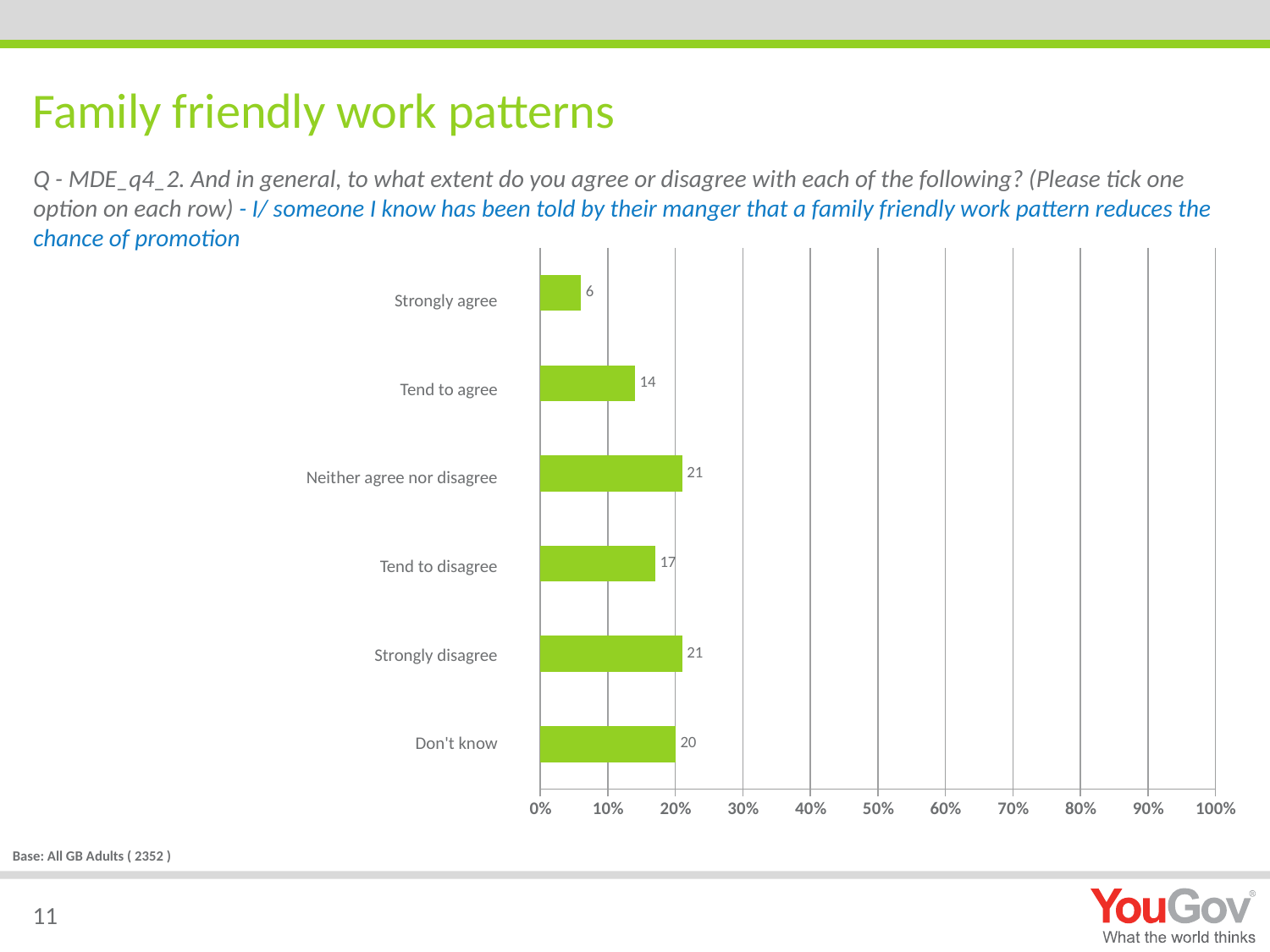
What is the difference between the values for "Neither agree nor disagree" and "Tend to agree"? 7 What is the value for "Tend to agree"? 14 What is the highest value shown on the x axis? 100% What is the value for "Strongly agree"? 6 How many categories are shown in the chart? 6 What is the difference between the values for "Don't know" and "Strongly agree"? 14 Which is larger, the value for "Tend to disagree" or the value for "Tend to agree"? Tend to disagree What is the value for "Tend to disagree"? 17 Which category has the lowest value? Strongly agree What is the value for "Don't know"? 20 Is the value for "Strongly disagree" greater or less than 10%? greater What kind of chart is shown on the slide? Bar chart